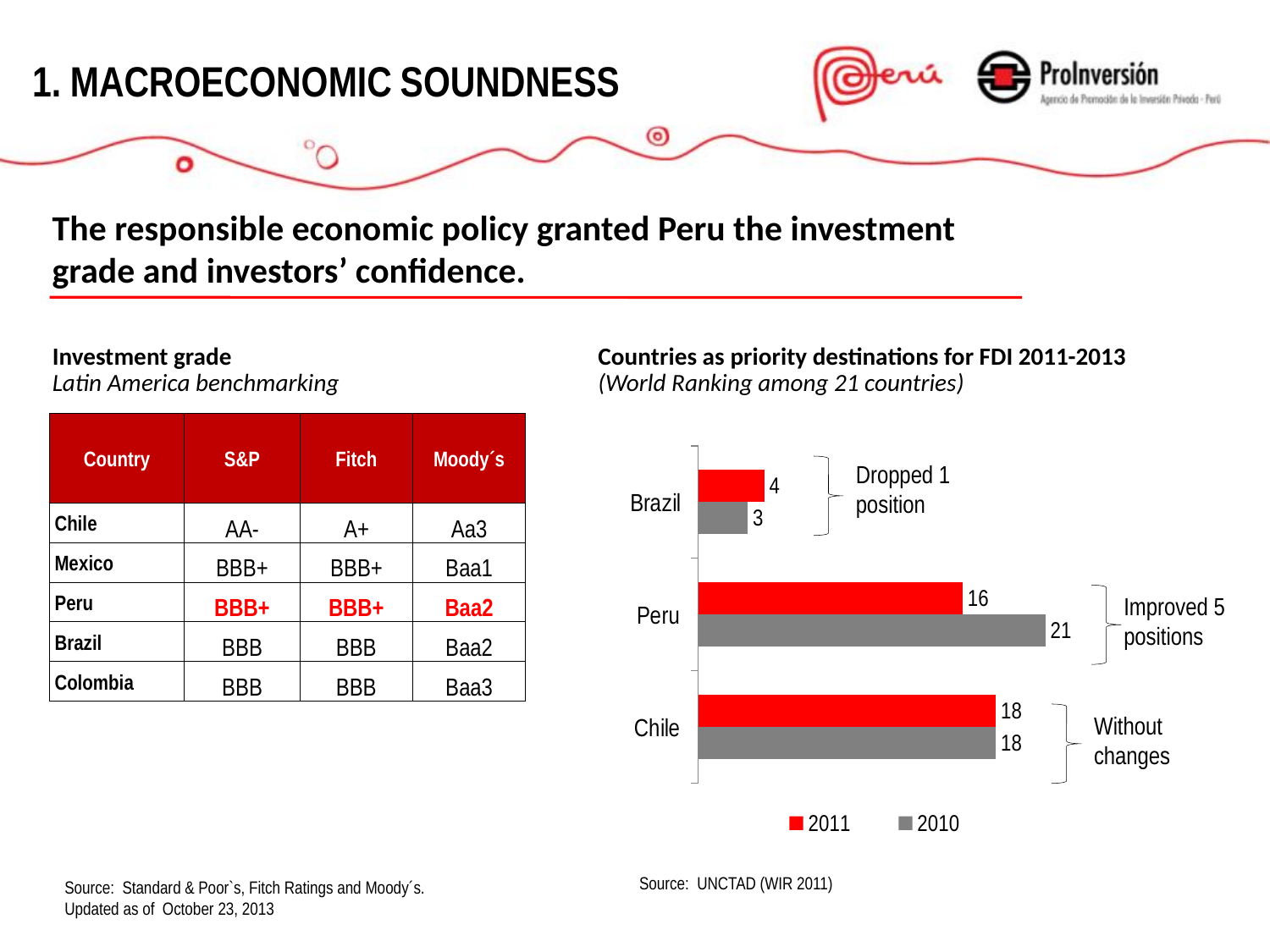
In the FDI priority destinations chart, is Peru's 2011 value or Chile's 2011 value larger? Chile's 2011 value What is Chile's 2011 value in the FDI priority destinations chart? 18 What is Brazil's 2010 value in the FDI priority destinations chart? 3 How many series does the legend of the FDI priority destinations chart list? 2 What is Peru's 2010 value in the FDI priority destinations chart? 21 What kind of chart is shown under "Countries as priority destinations for FDI 2011-2013"? bar chart In the FDI priority destinations chart, what is the difference between Peru's 2010 and 2011 values? 5 How many countries are shown in the FDI priority destinations chart? 3 What is Brazil's 2011 value in the FDI priority destinations chart? 4 What is Peru's 2011 value in the FDI priority destinations chart? 16 Which country has the lowest 2010 value in the FDI priority destinations chart? Brazil Which country has the highest 2011 value in the FDI priority destinations chart? Chile